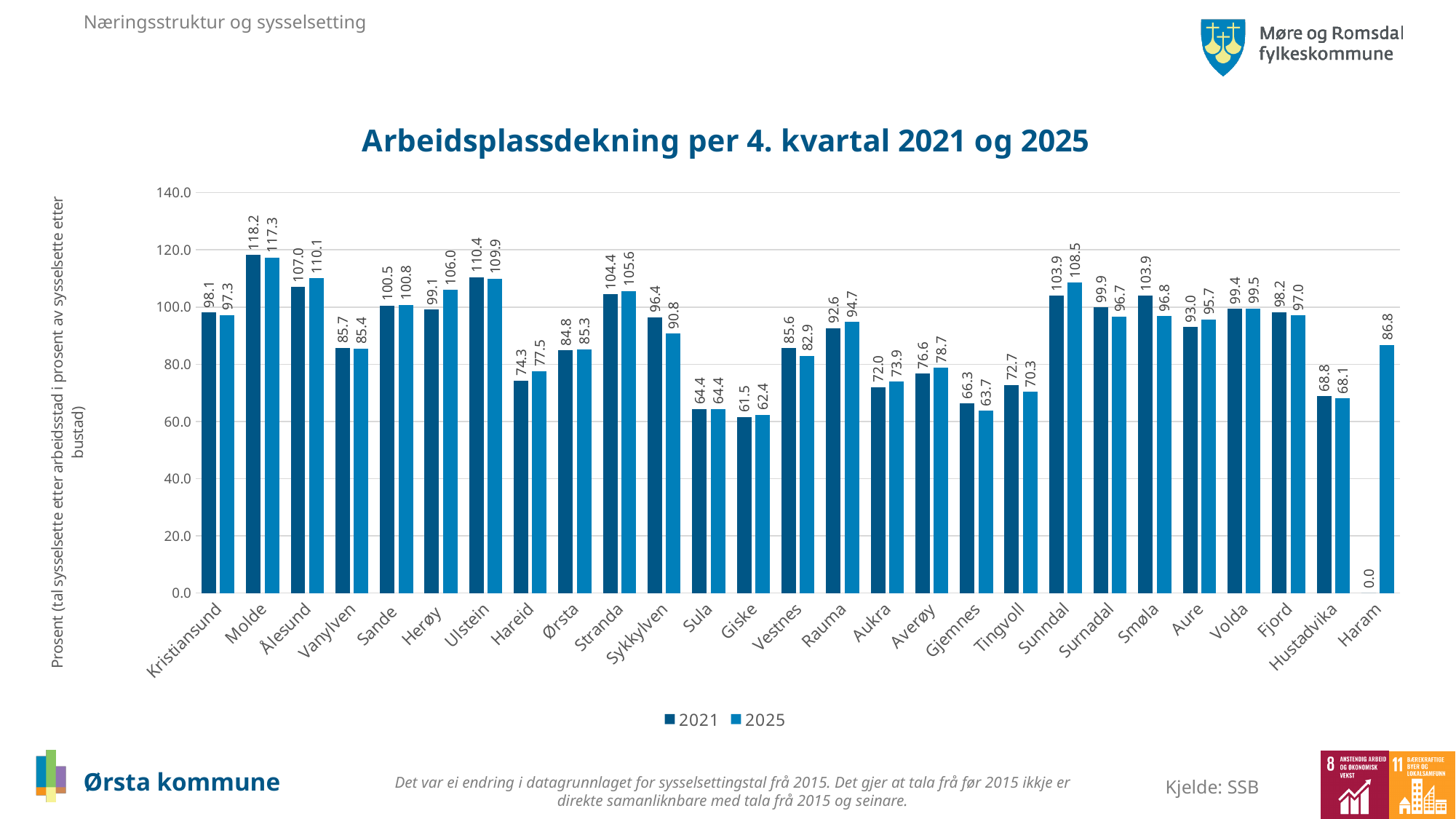
What kind of chart is shown on the slide? Bar chart What is the 2025 value for Sunndal? 108.5 What is the 2025 value for Haram? 86.8 How many municipalities are shown on the x axis? 27 What is the 2021 value for Ørsta? 84.8 What is the difference between the 2025 and 2021 values for Herøy? 6.9 Which municipality has the lowest 2025 value? Giske What is the title of the chart? Arbeidsplassdekning per 4. kvartal 2021 og 2025 Which is larger for Sykkylven, the 2021 value or the 2025 value? 2021 Which municipality has the highest 2025 value? Molde How many series does the legend list? 2 Is the 2021 value for Ulstein greater or less than 100? greater